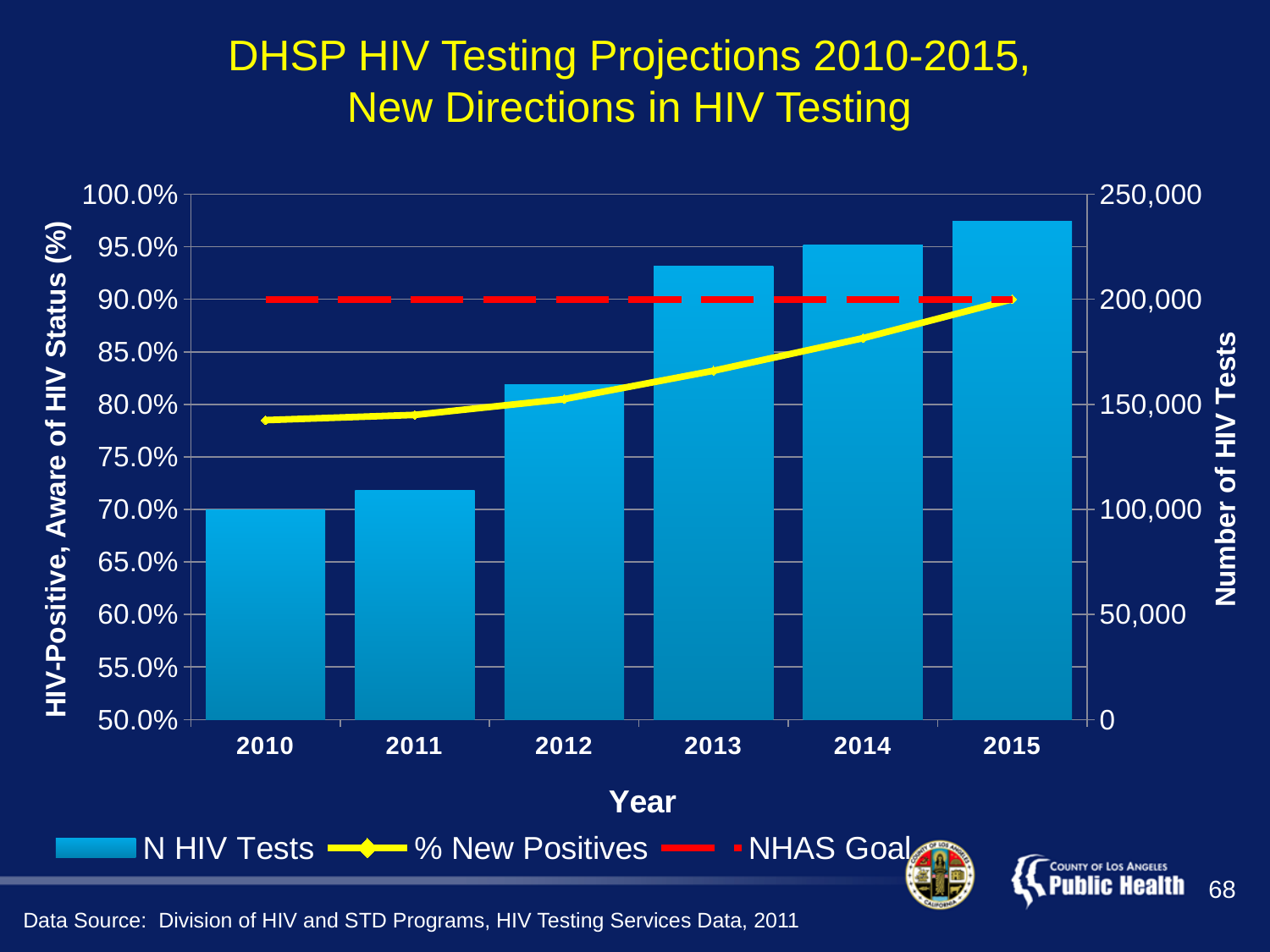
Do the N HIV Tests bars rise or fall from 2010 to 2015? Rise What kind of chart is shown on the slide? A combination bar and line chart What value does the NHAS Goal line sit at on the left axis? 90.0% How many years are shown along the x axis? 6 Which year has more HIV tests, 2012 or 2013? 2013 Which year has the lowest number of HIV tests? 2010 How many series does the legend list? 3 Which year has the highest number of HIV tests? 2015 Is the number of HIV tests for 2013 greater or less than 200,000? greater Is the number of HIV tests for 2011 greater or less than 150,000? less What is the title of the right-hand vertical axis? Number of HIV Tests Is the % New Positives value for 2010 greater or less than 80.0%? less